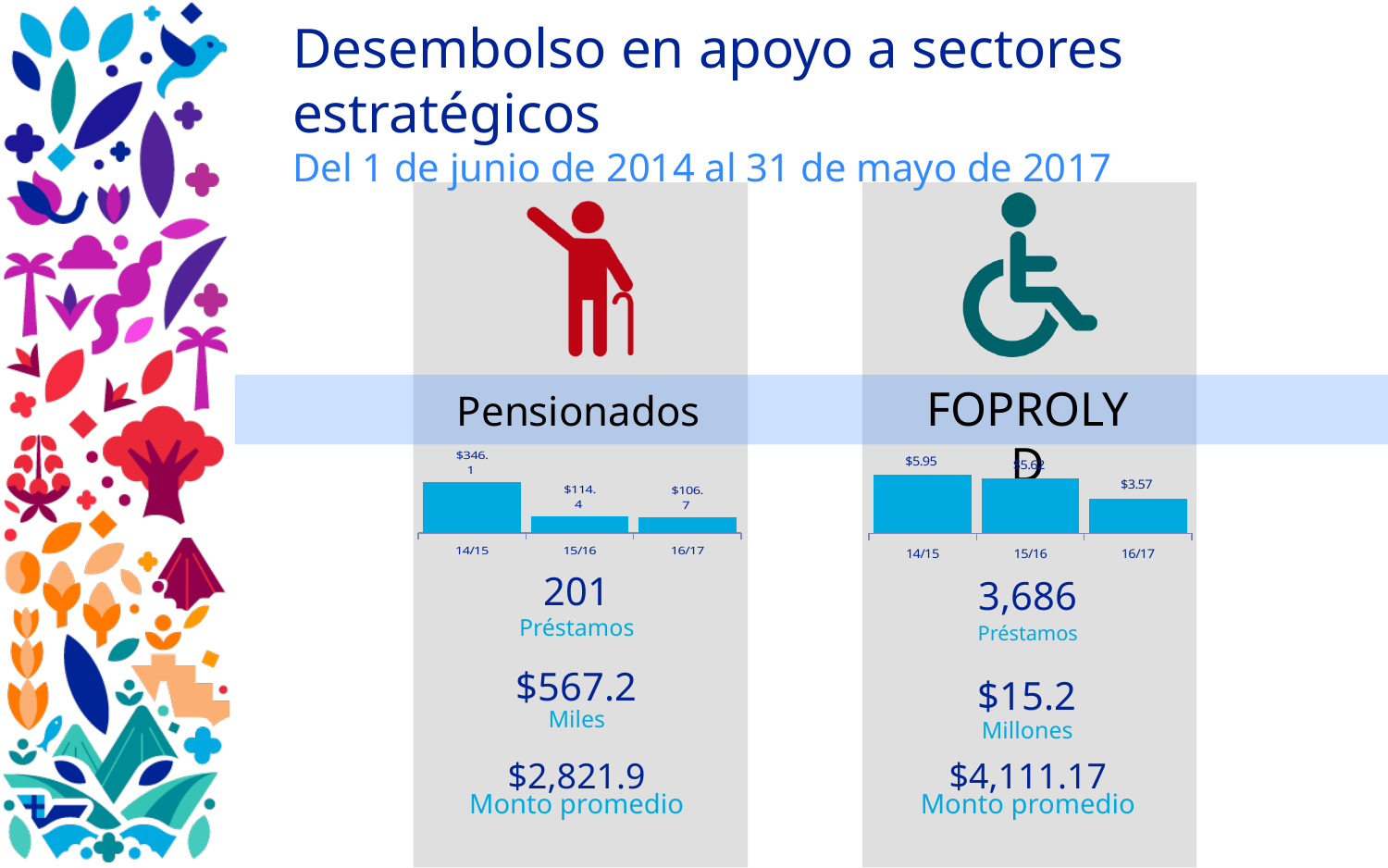
In the Pensionados chart, which period has the lowest value? 16/17 In the Pensionados chart, which period has the highest value? 14/15 In the Pensionados chart, what is the value for 16/17? $106.7 In the FOPROLYD chart, what is the value for 16/17? $3.57 In the Pensionados chart, what is the value for 14/15? $346.1 In the Pensionados chart, what is the value for 15/16? $114.4 In the Pensionados chart, what is the difference between the 14/15 and 15/16 values? $231.7 In the FOPROLYD chart, which period has the lowest value? 16/17 How many periods are shown in the Pensionados chart? 3 In the FOPROLYD chart, which is larger, the value for 14/15 or the value for 16/17? 14/15 What type of chart is used for the FOPROLYD data? Bar chart In the FOPROLYD chart, what is the value for 14/15? $5.95